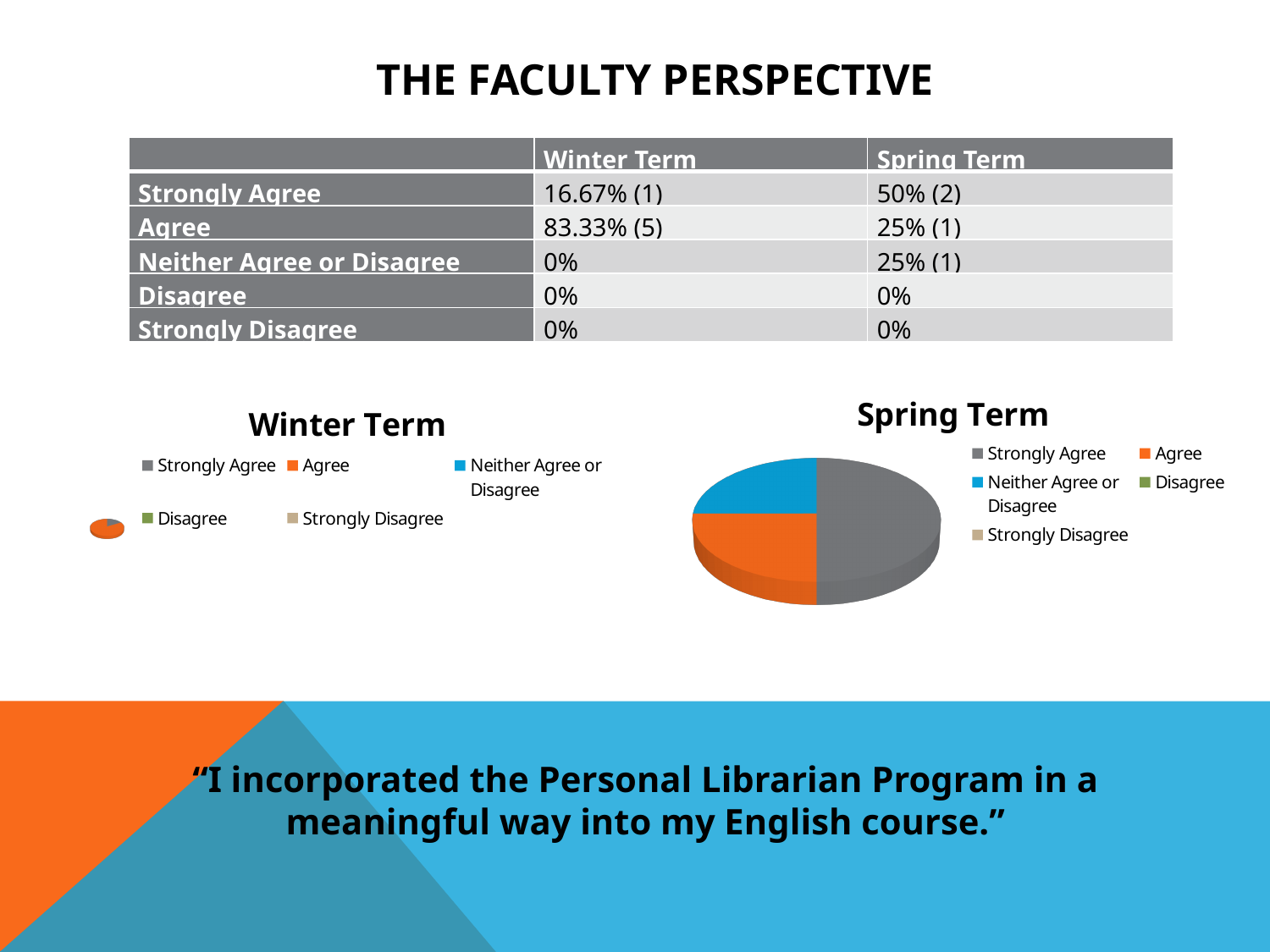
How many entries does the legend of the Spring Term chart list? 5 What kind of chart is the Spring Term chart? pie chart In the Winter Term chart, what is the value for Agree? 83.33% (5) In the Winter Term chart, which category has the largest slice? Agree In the Winter Term chart, what is the difference between the Agree and Strongly Agree percentages? 66.66% In the Spring Term chart, how many categories have a non-zero slice? 3 In the Spring Term chart, what share of the pie does Strongly Agree take? 50% In the Spring Term chart legend, what colour represents Agree? orange In the Spring Term chart, what is the value for Neither Agree or Disagree? 25% (1) In the Spring Term chart, which category has the largest slice? Strongly Agree In the Spring Term chart, which is larger: Strongly Agree or Agree? Strongly Agree How many entries does the legend of the Winter Term chart list? 5